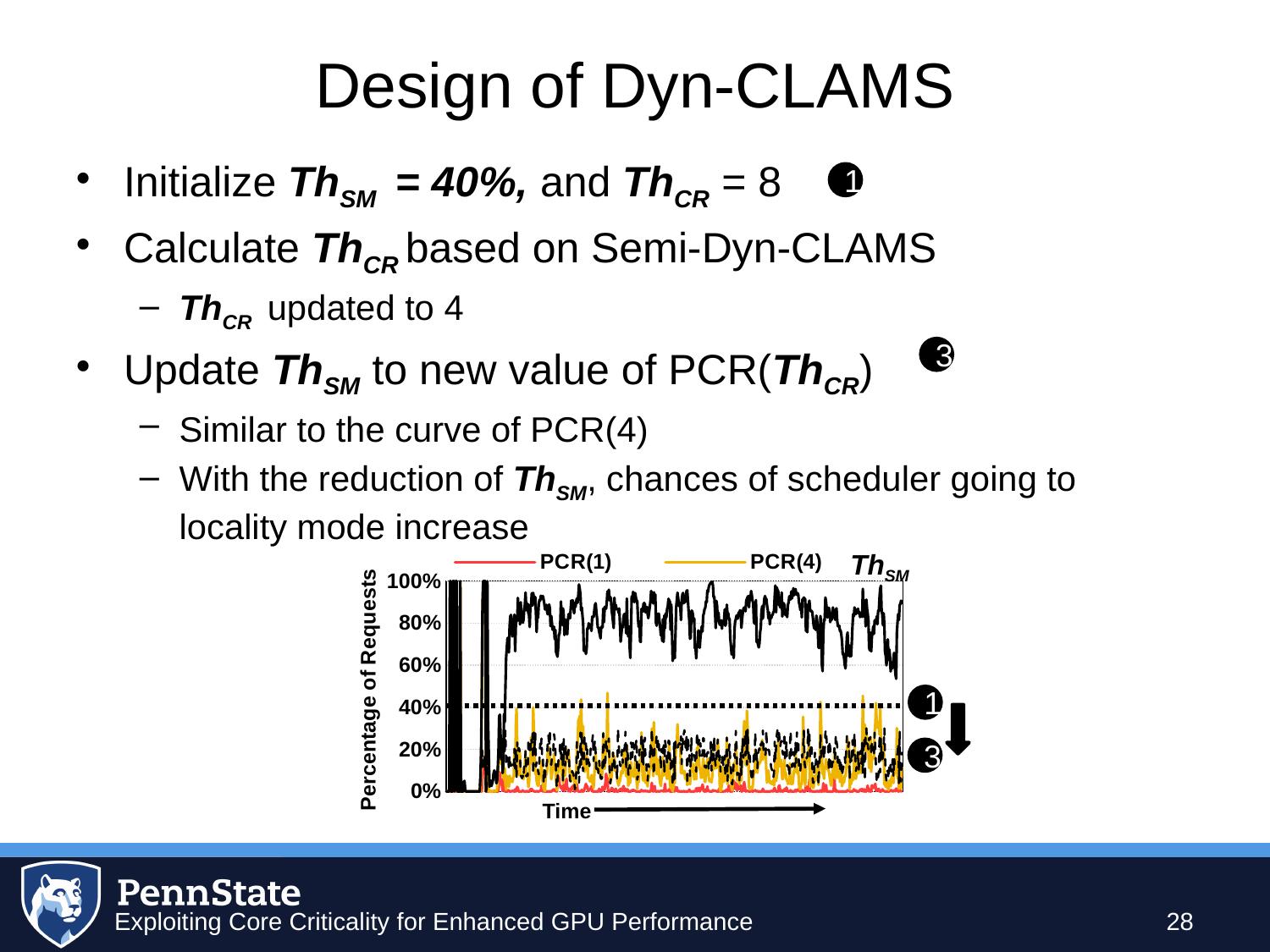
At what percentage level is the horizontal dotted line (the initial Th_SM) drawn on the chart? 40% After the initial spike, is the solid black curve mostly greater or less than 60%? greater What is the label of the vertical axis of the chart? Percentage of Requests How many series does the chart legend list? 3 Is the PCR(4) curve mostly greater or less than 40% on the chart? less What is the label of the horizontal axis of the chart? Time Is the PCR(1) curve mostly greater or less than 20% on the chart? less What is the highest tick value shown on the vertical axis of the chart? 100% What kind of chart is shown on the slide? line chart Which of the two legend series, PCR(1) or PCR(4), generally has the higher values on the chart? PCR(4)